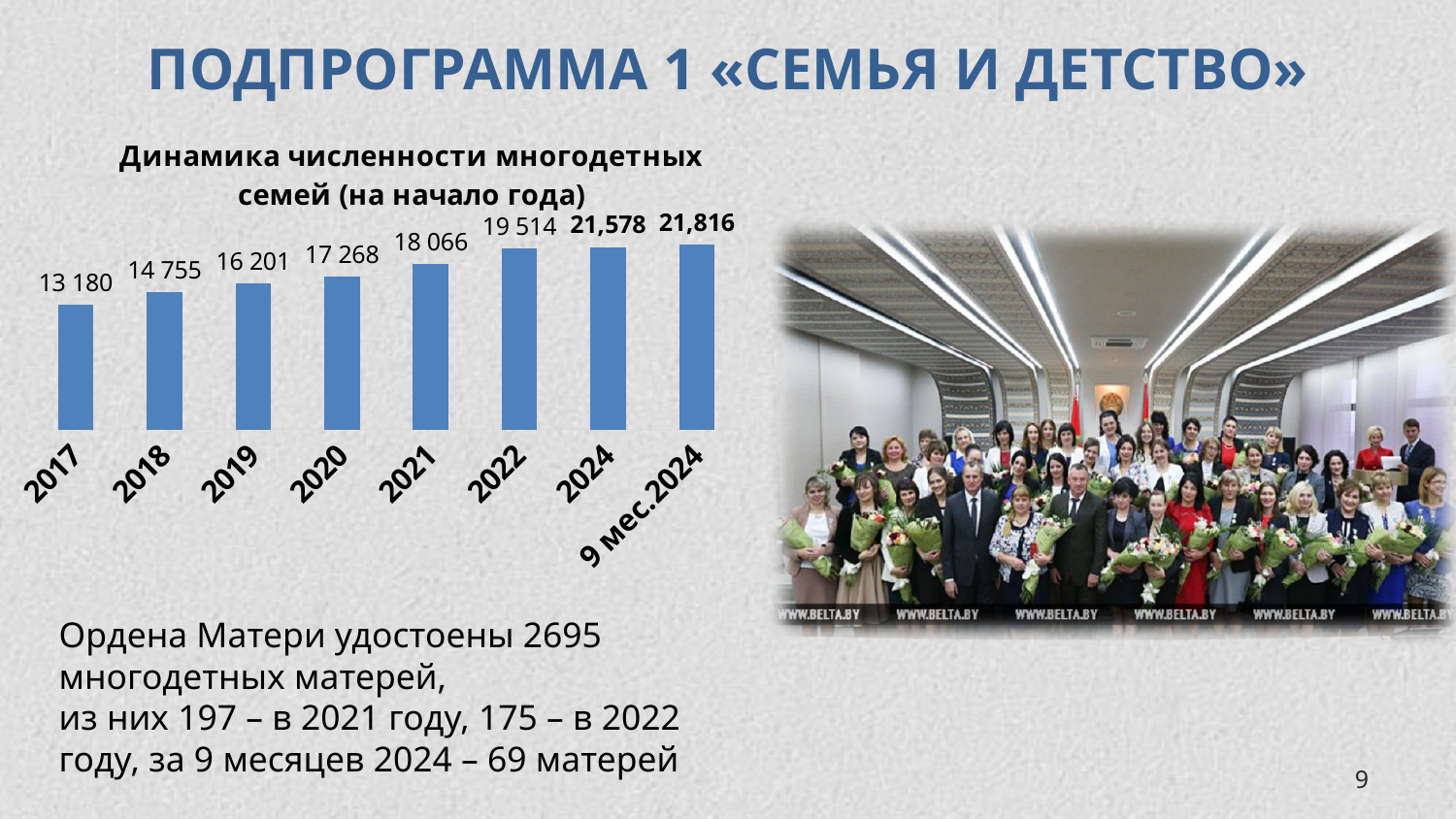
What is the value for 2017 in the chart 'Динамика численности многодетных семей (на начало года)'? 13 180 What is the value for '9 мес.2024' in the chart? 21,816 How many categories are shown on the x axis of the chart? 8 What is the value for 2020 in the chart? 17 268 What is the value for 2022 in the chart? 19 514 Do the values rise or fall from 2017 to 9 мес.2024 along the x axis? Rise Which category has the lowest value in the chart? 2017 What is the difference between the values for 2024 and 2022? 2 064 What is the difference between the values for 2018 and 2017? 1 575 What type of chart is shown on the slide? Bar chart Which category has the highest value in the chart? 9 мес.2024 Which is larger, the value for 2019 or the value for 2021? 2021